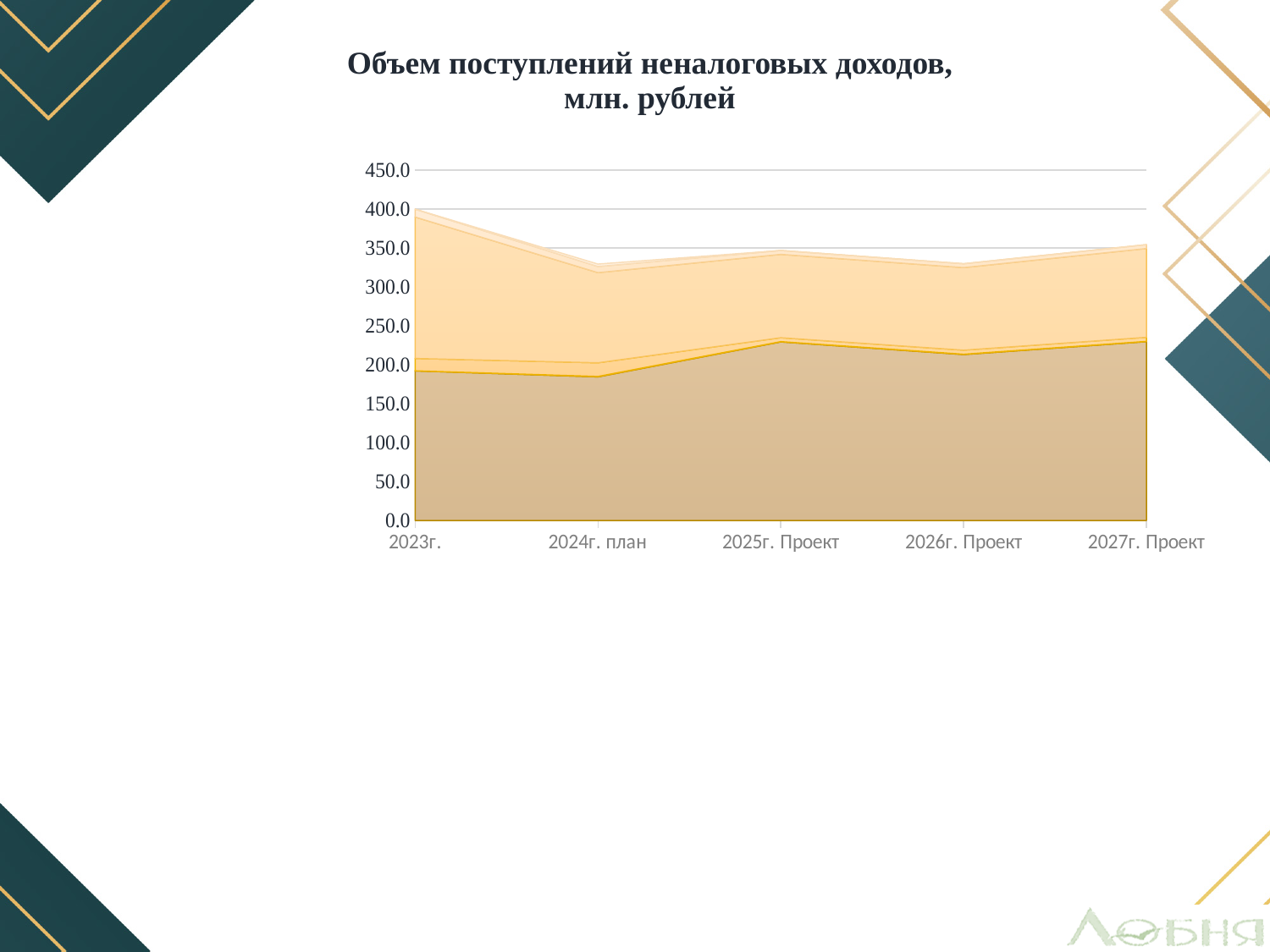
Is the value of the lower (darker) series for 2025г. Проект greater or less than 200? greater Which is larger, the total for 2023г. or the total for 2024г. план? 2023г. How many categories are shown along the x axis? 5 Which category has the highest total (top of the stacked area)? 2023г. Is the total value for 2026г. Проект greater or less than 350? less Is the value of the lower (darker) series for 2027г. Проект greater or less than 200? greater Does the total (top of the stacked area) rise or fall from 2023г. to 2024г. план? fall What is the title of the chart? Объем поступлений неналоговых доходов, млн. рублей What kind of chart is shown on the slide? area chart